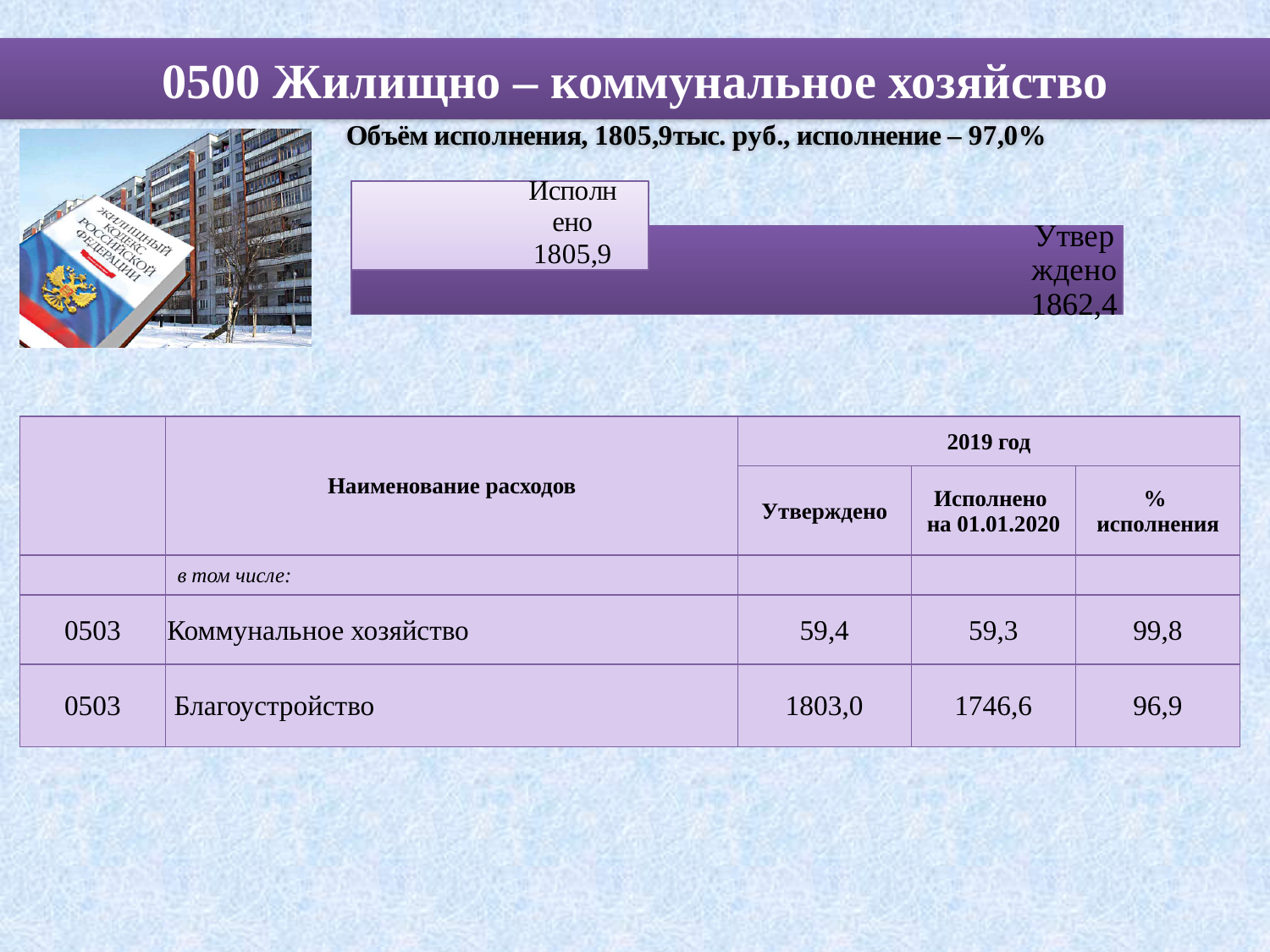
What is the difference between the Утверждено value and the Исполнено value? 56,5 What is the value of the bar labelled Исполнено? 1805,9 What is the value of the bar labelled Утверждено? 1862,4 Which bar in the chart has the largest value? Утверждено Which bar in the chart has the smallest value? Исполнено Are the bars in the chart horizontal or vertical? horizontal Which bar has the higher value, Исполнено or Утверждено? Утверждено How many bars are plotted in the chart? 2 What kind of chart is shown on the slide? bar chart Which bar is drawn in the darker purple colour? Утверждено